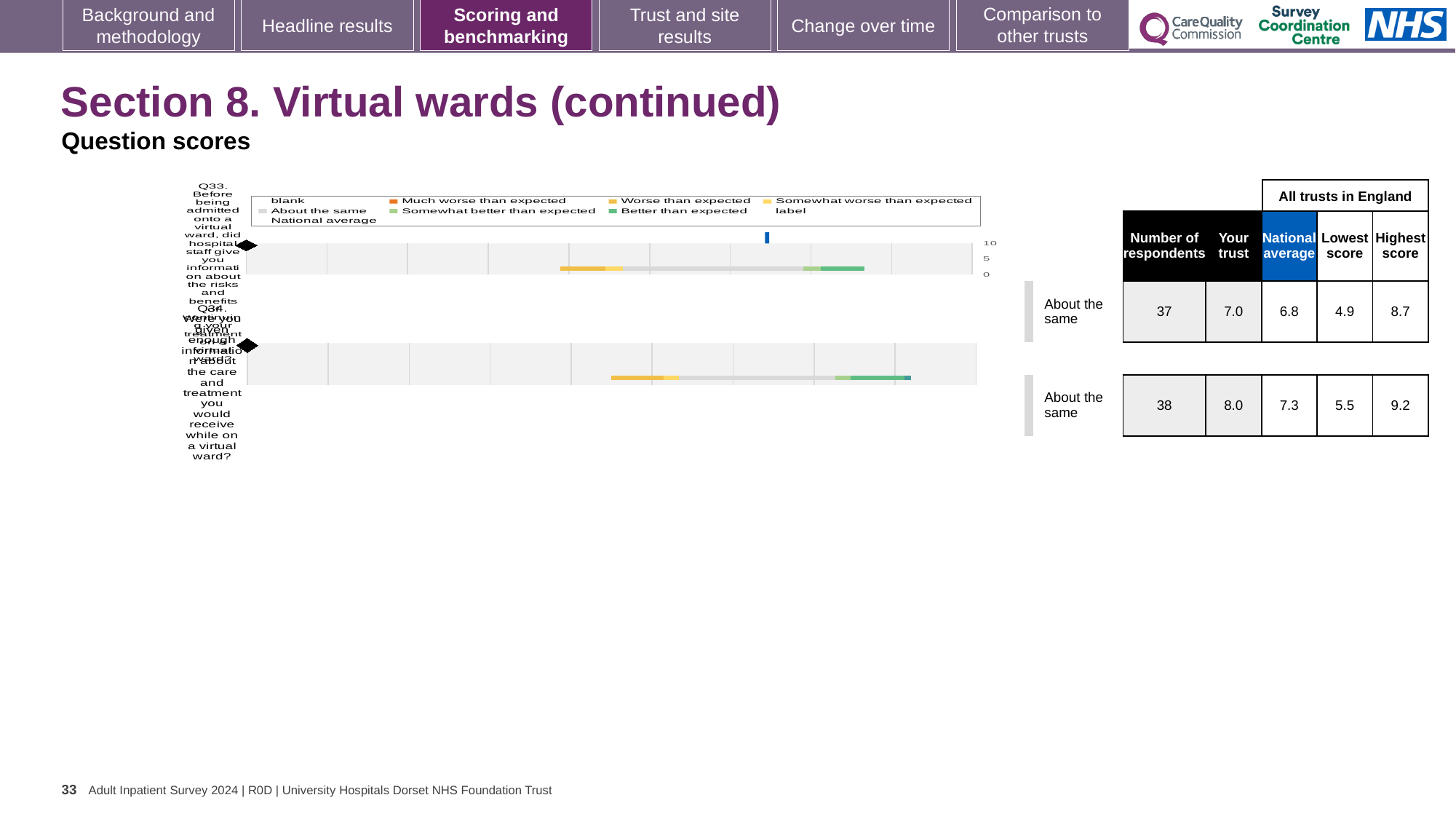
What is the 'Your trust' score for Q34 (enough information about the care and treatment on a virtual ward)? 8.0 What kind of chart is used to show the question scores? Bar chart What colour represents 'Better than expected' in the chart legend? Green By how much does the trust's score for Q33 exceed the national average? 0.2 What is the 'Your trust' score for Q33 (information about the risks and benefits before being admitted onto a virtual ward)? 7.0 Which question has the higher 'Highest score' across all trusts in England? Q34 Which question has the higher 'Your trust' score, Q33 or Q34? Q34 What is the difference between the highest score and the lowest score for Q34 across all trusts in England? 3.7 What is the national average score for Q33? 6.8 What benchmark category is the trust's result for Q33 placed in? About the same How many questions are plotted on the chart? 2 How many respondents answered Q34? 38